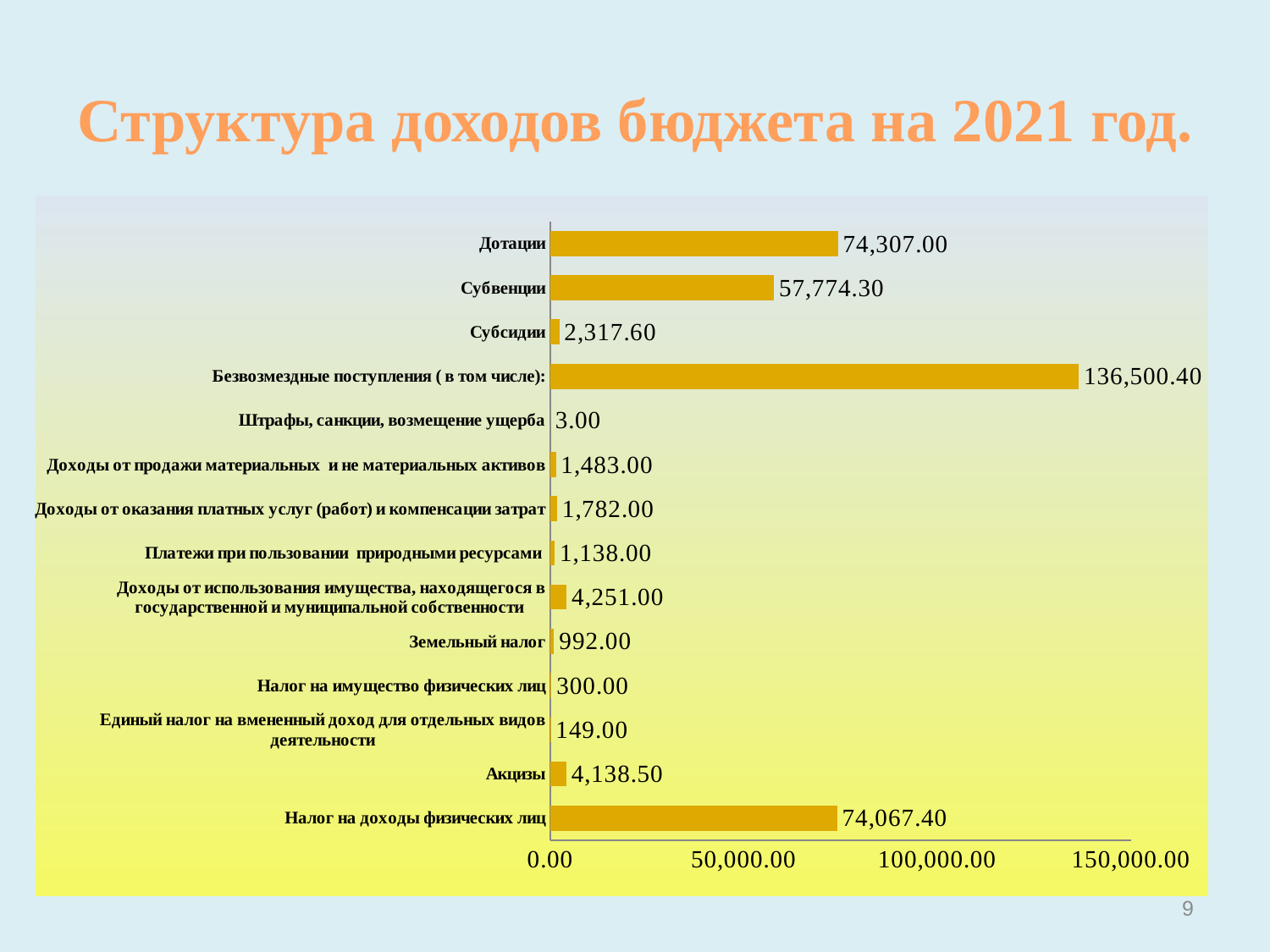
What is the value for Налог на доходы физических лиц? 74,067.40 What type of chart is shown on the slide? Bar chart What is the difference between the values for Дотации and Субвенции? 16,532.70 What is the title of the slide? Структура доходов бюджета на 2021 год. Which category has the highest value? Безвозмездные поступления ( в том числе): How many categories are plotted in the chart? 14 What is the value for Акцизы? 4,138.50 What is the difference between the values for Безвозмездные поступления ( в том числе): and Дотации? 62,193.40 Is the value for Субвенции greater or less than 50,000.00? greater Which is larger, the value for Субвенции or the value for Субсидии? Субвенции What is the value for Дотации? 74,307.00 Which category has the lowest value? Штрафы, санкции, возмещение ущерба